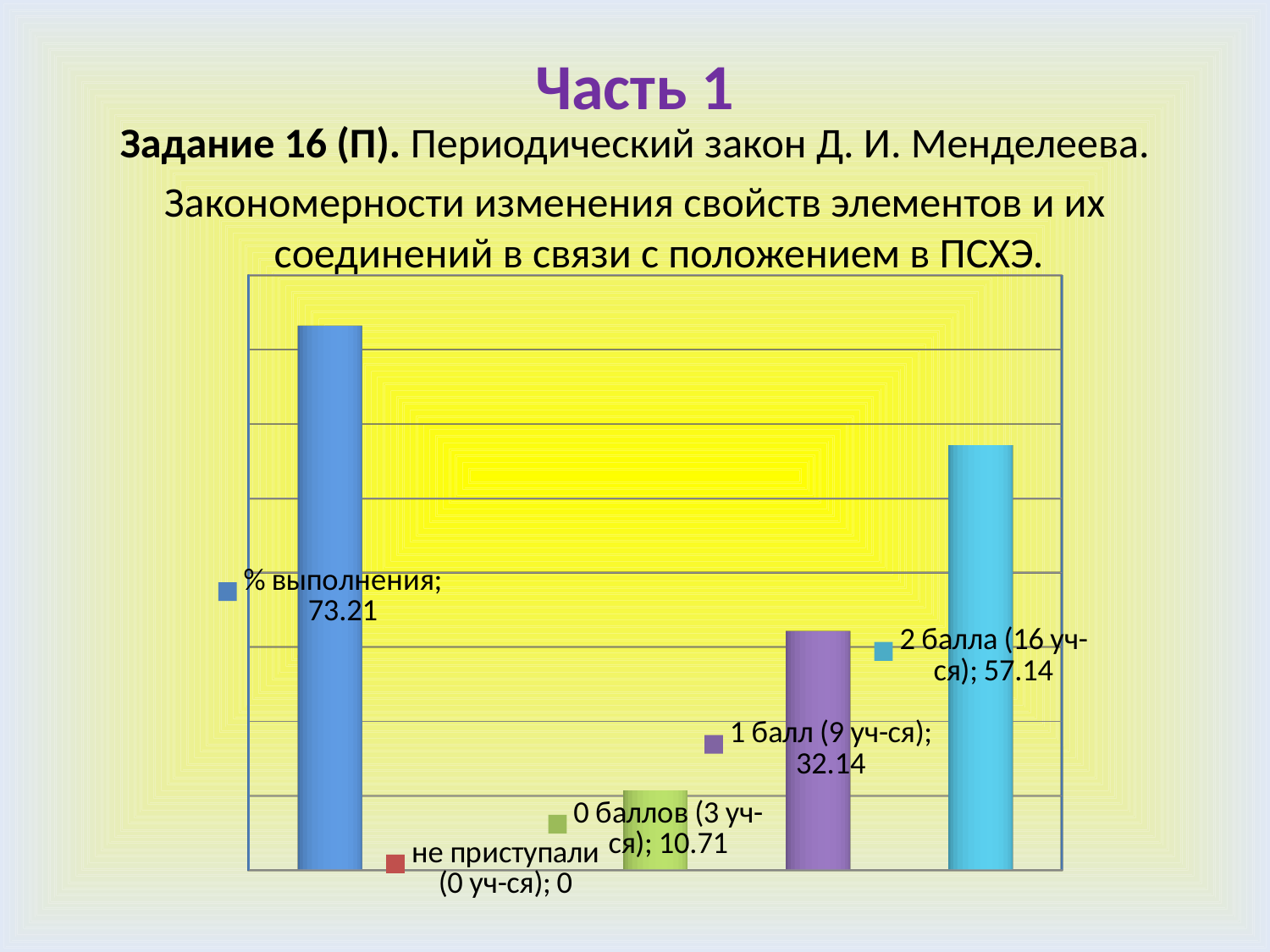
What value is shown for "не приступали (0 уч-ся)"? 0 Which category has the highest value? % выполнения What is the difference between the values for "% выполнения" and "2 балла (16 уч-ся)"? 16.07 What kind of chart is shown on the slide? bar chart What value is shown for "1 балл (9 уч-ся)"? 32.14 What value is shown for "% выполнения"? 73.21 What value is shown for "0 баллов (3 уч-ся)"? 10.71 Which is larger, the value for "1 балл (9 уч-ся)" or the value for "0 баллов (3 уч-ся)"? 1 балл (9 уч-ся) Which category has the lowest value? не приступали (0 уч-ся) What value is shown for "2 балла (16 уч-ся)"? 57.14 How many bars are plotted in the chart? 4 What is the difference between the values for "2 балла (16 уч-ся)" and "1 балл (9 уч-ся)"? 25